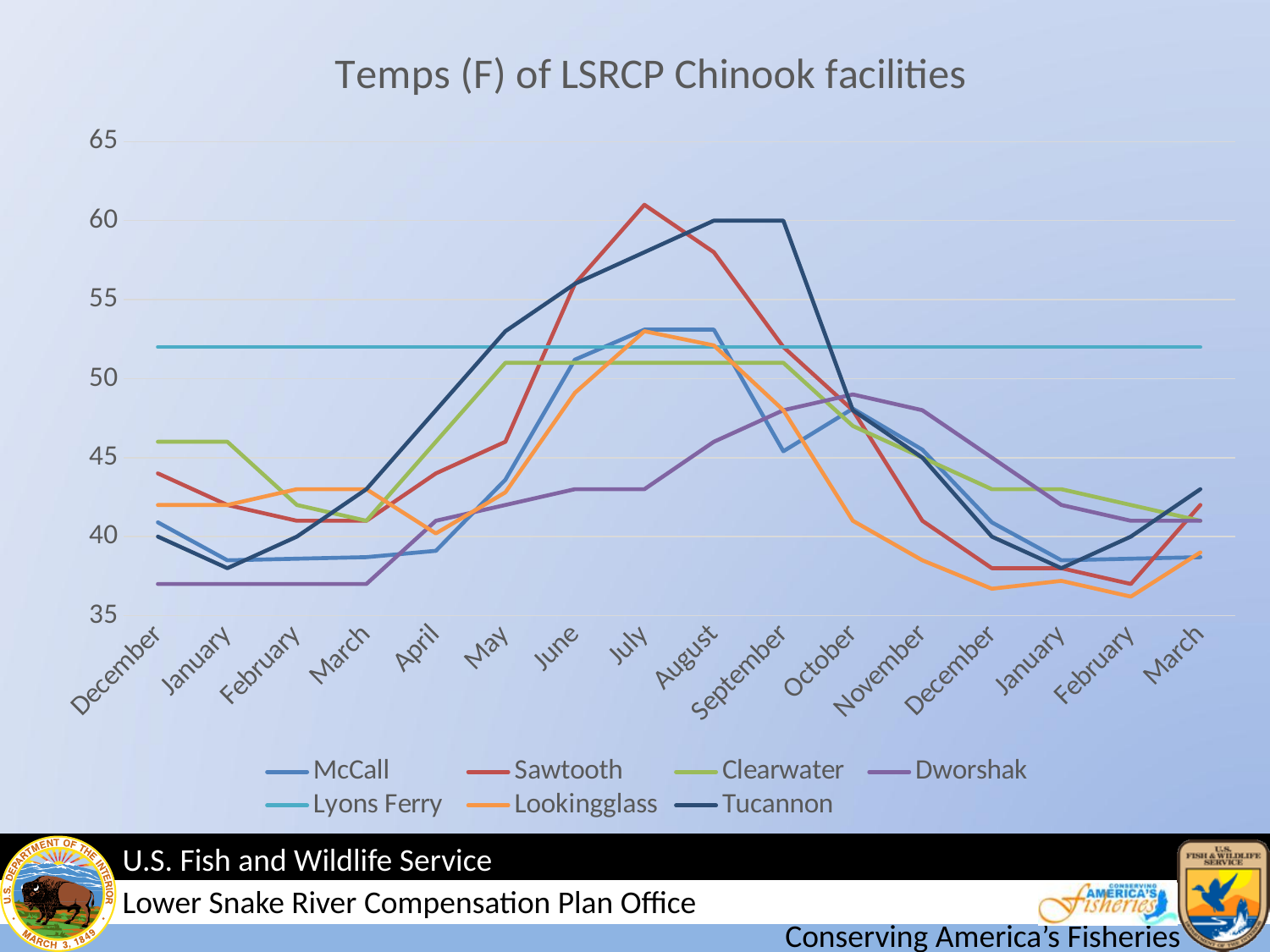
Which facility has the lowest temperature in the first December shown? Dworshak Is the value for McCall in September greater or less than 50? less Does the Sawtooth line rise or fall from March to July? rises Is the value for Lyons Ferry greater or less than 50? greater Which is larger in July, the value for Sawtooth or the value for Dworshak? Sawtooth What kind of chart is shown on the slide? line chart Is the value for Dworshak in the first December greater or less than 40? less Which facility has the highest temperature in July? Sawtooth How many series does the legend list? 7 How many months are shown along the x axis? 16 What is the title of the chart? Temps (F) of LSRCP Chinook facilities